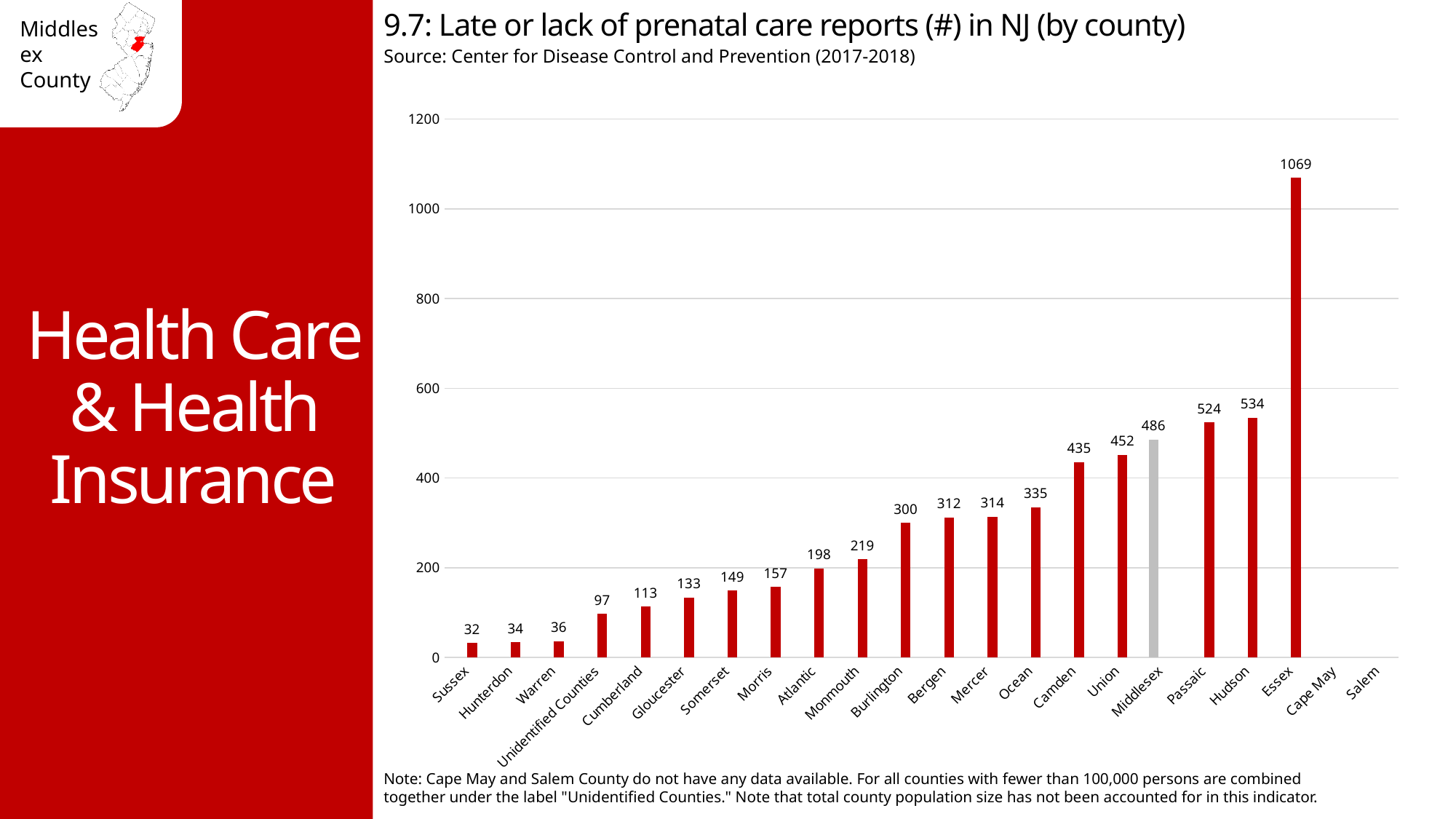
What is the number of late or lack of prenatal care reports for Middlesex? 486 Is the value for Burlington greater or less than 200? greater How many categories are labelled on the x axis? 22 Do the values rise or fall moving from Sussex to Essex along the x axis? Rise What is the difference between the values for Hudson and Passaic? 10 What is the value shown for Essex? 1069 Which has a higher value, Camden or Union? Union What kind of chart is shown on the slide? Bar chart Which county has the highest number of late or lack of prenatal care reports? Essex What is the value shown for Sussex? 32 Which county has the lowest number of reports among those with data shown? Sussex Which bar is coloured grey instead of red? Middlesex